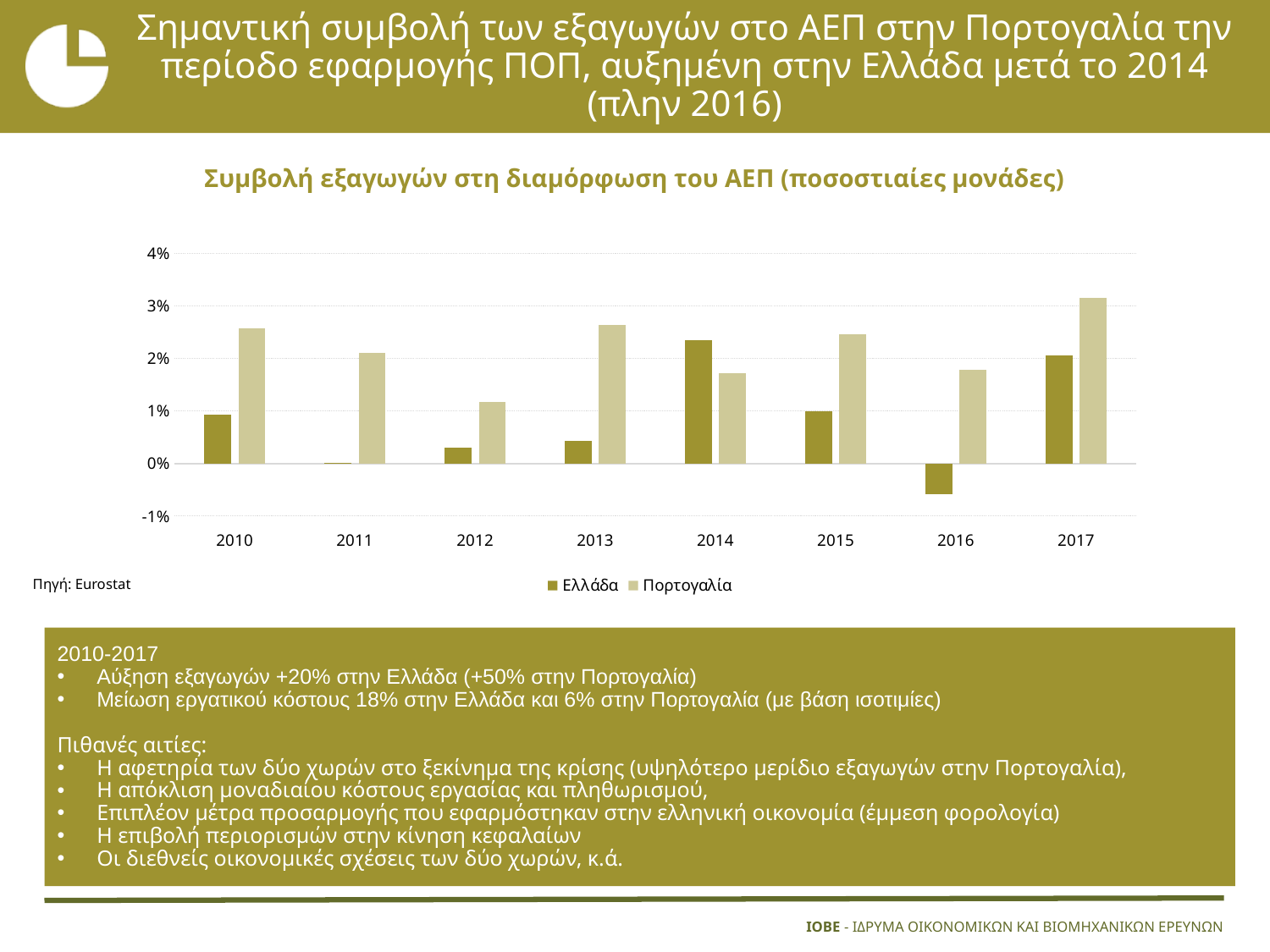
What kind of chart is shown on the slide? Bar chart In which year is the value for Ελλάδα lowest? 2016 In which year is the value for Πορτογαλία highest? 2017 In 2014, which is larger, the value for Ελλάδα or for Πορτογαλία? Ελλάδα What is the title of the chart? Συμβολή εξαγωγών στη διαμόρφωση του ΑΕΠ (ποσοστιαίες μονάδες) In which year is the value for Ελλάδα highest? 2014 How many years are shown on the x axis? 8 Is the value for Πορτογαλία in 2017 greater or less than 3%? greater In which year is the value for Πορτογαλία lowest? 2012 How many series does the legend list? 2 Is the value for Ελλάδα in 2016 greater or less than 0%? less Which series are listed in the legend? Ελλάδα and Πορτογαλία